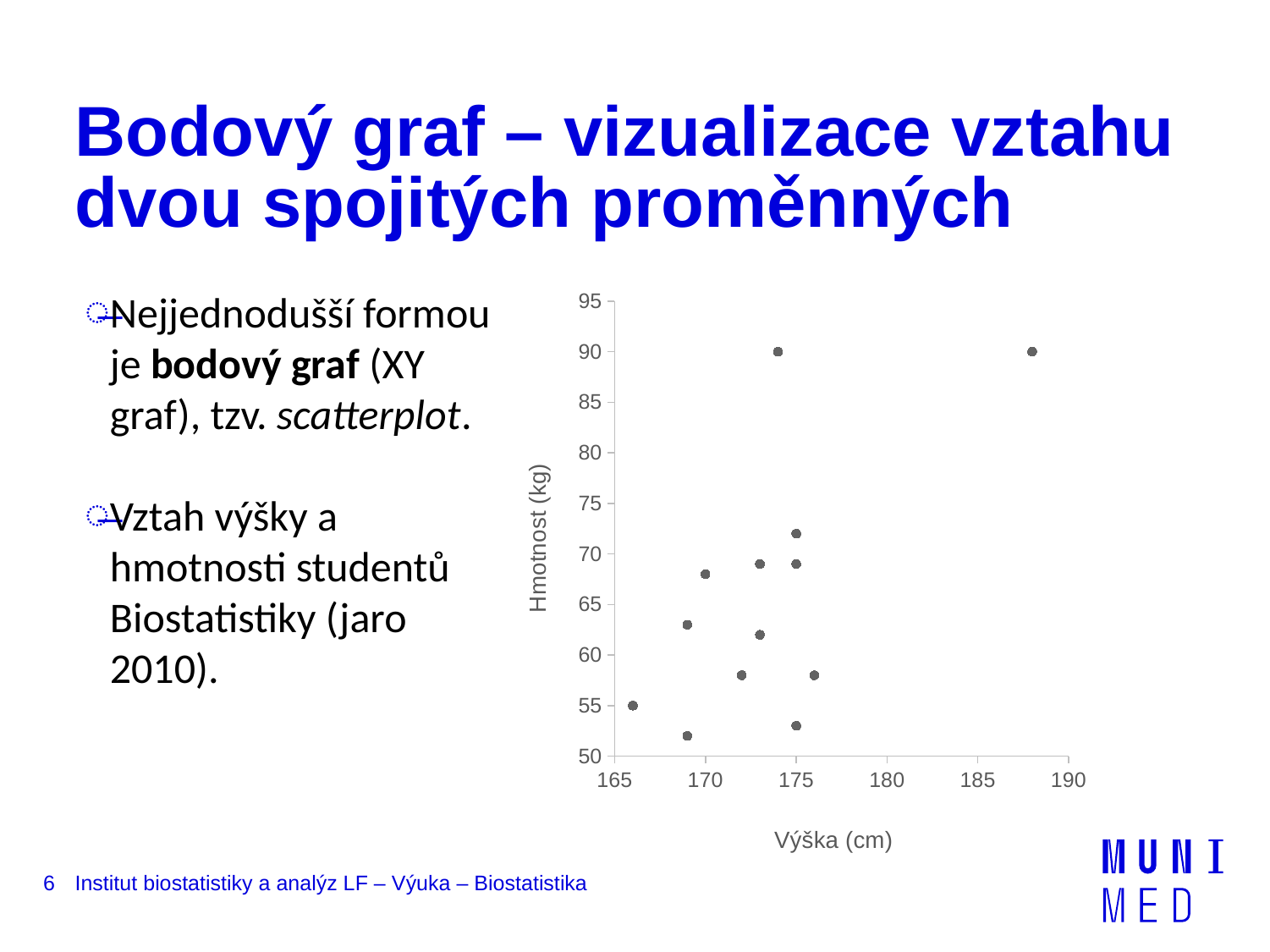
What kind of chart is shown on the slide? scatter plot What is the label of the vertical axis of the chart? Hmotnost (kg) Which point has the greater weight: the one at 166 cm or the one at 176 cm? the one at 176 cm Which point has the greater weight: the one at 170 cm or the one at 172 cm? the one at 170 cm Is the weight of the point at 172 cm greater or less than 60? less Is the weight of the point at 170 cm greater or less than 65? greater How many data points are plotted in the chart? 13 Is the weight of the rightmost point (at about 188 cm) greater or less than 85? greater What is the highest tick value shown on the vertical axis? 95 What is the label of the horizontal axis of the chart? Výška (cm)